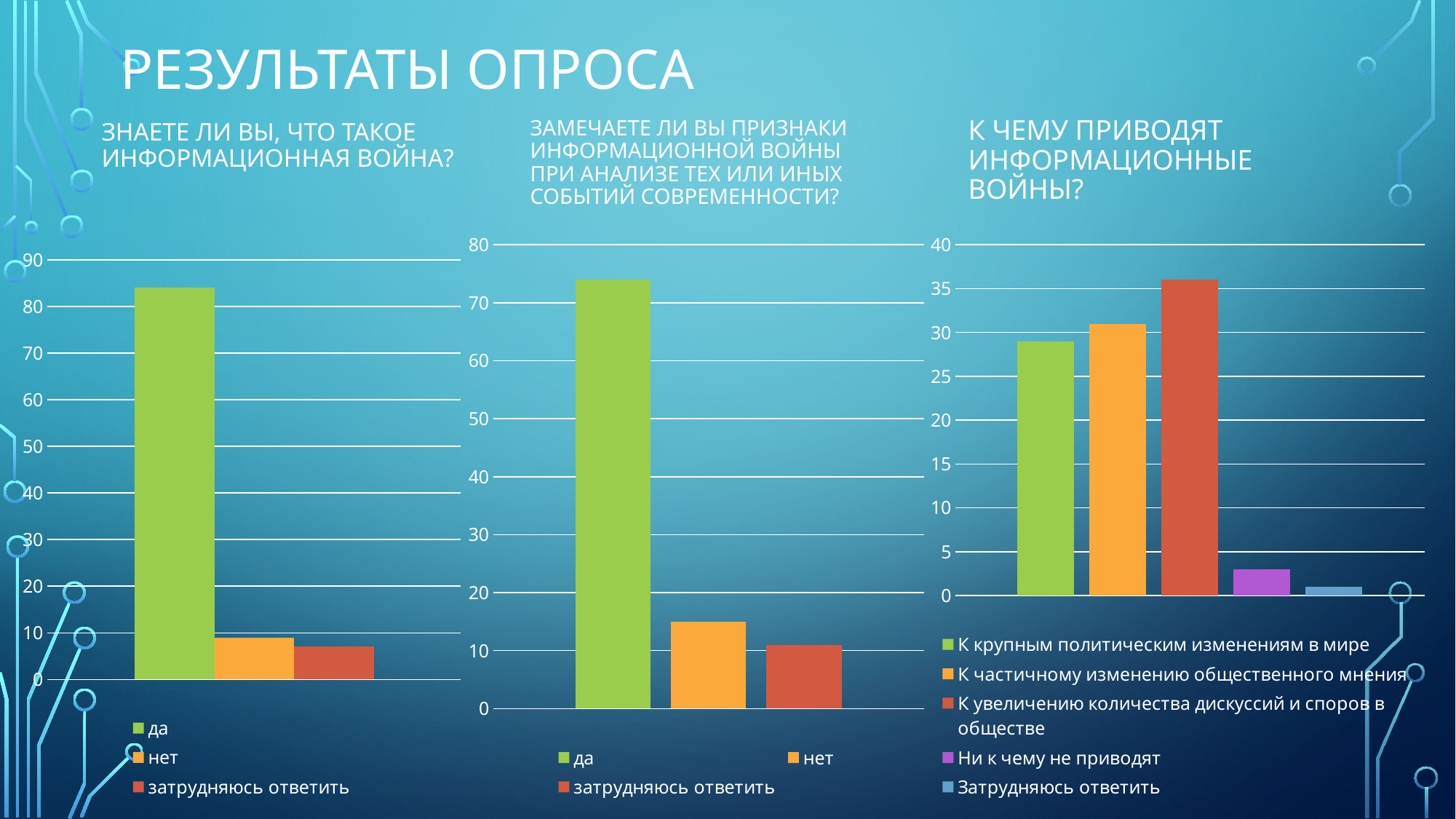
What kind of chart is the chart titled "Знаете ли вы, что такое информационная война?"? bar chart How many entries does the legend list in the chart titled "К чему приводят информационные войны?"? 5 In the chart titled "Замечаете ли вы признаки информационной войны при анализе тех или иных событий современности?", is the value for "да" greater or less than 70? greater In the chart titled "Замечаете ли вы признаки информационной войны при анализе тех или иных событий современности?", which answer has the highest bar? да In the chart titled "К чему приводят информационные войны?", is the value for "К увеличению количества дискуссий и споров в обществе" greater or less than 35? greater In the chart titled "Замечаете ли вы признаки информационной войны при анализе тех или иных событий современности?", which is larger: "нет" or "затрудняюсь ответить"? нет In the chart titled "Знаете ли вы, что такое информационная война?", is the value for "да" greater or less than 80? greater In the chart titled "К чему приводят информационные войны?", which answer has the highest bar? К увеличению количества дискуссий и споров в обществе In the chart titled "Знаете ли вы, что такое информационная война?", which answer has the highest bar? да In the chart titled "К чему приводят информационные войны?", which answer has the lowest bar? Затрудняюсь ответить